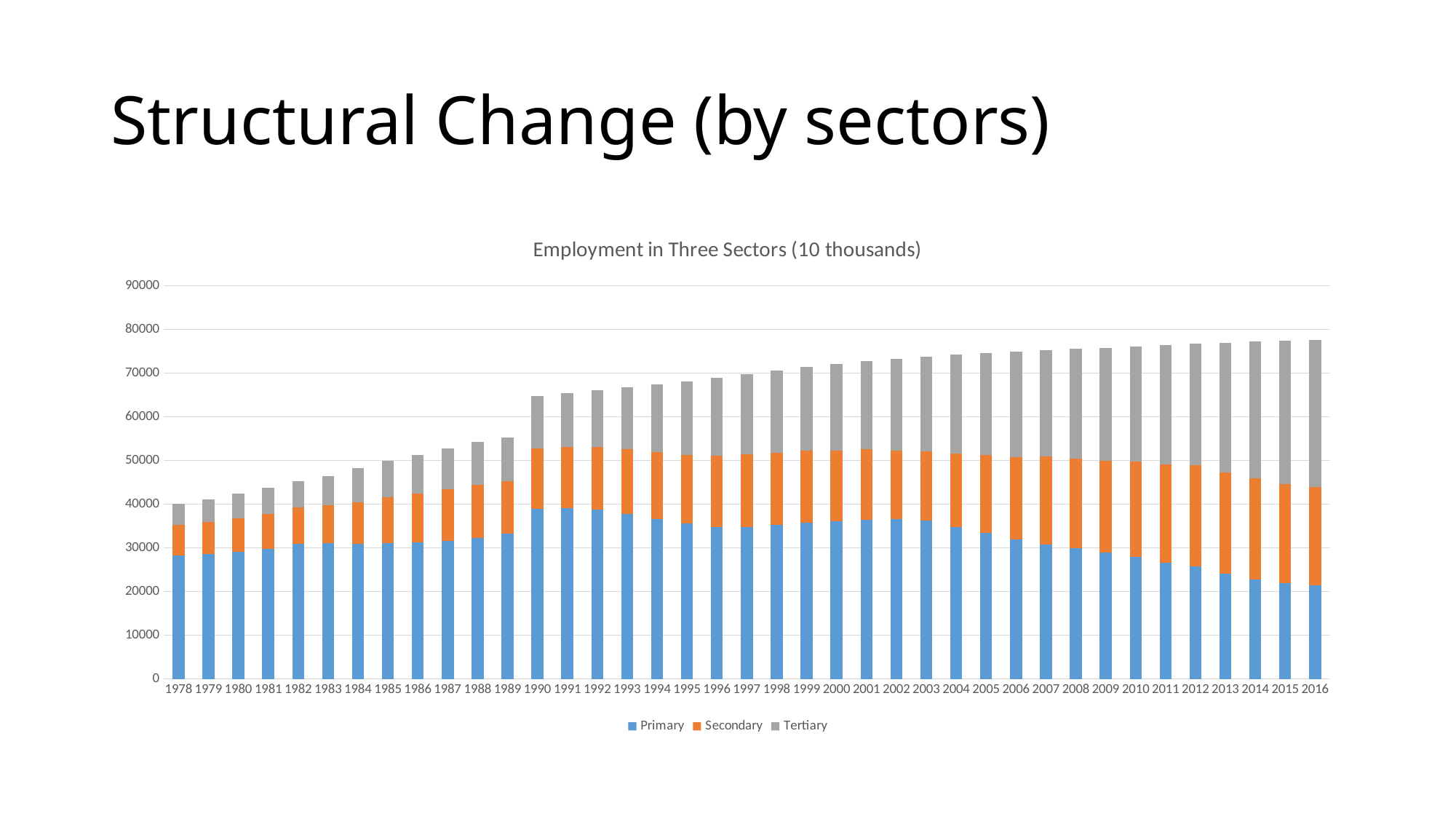
Is the total stacked bar for 1985 greater or less than 60000? less How many years are shown along the x axis? 39 Which year has the lowest total stacked bar? 1978 How many series does the legend list? 3 What is the title of the chart? Employment in Three Sectors (10 thousands) Is the total stacked bar for 2016 greater or less than 70000? greater Is the Primary value for 2016 greater or less than 30000? less What kind of chart is shown on the slide? Stacked bar chart Does the Primary sector value rise or fall from 2000 to 2016? fall Which series is shown in grey in the legend? Tertiary Does the total employment across the three sectors rise or fall from 1978 to 2016? rise Which year has the highest total stacked bar? 2016